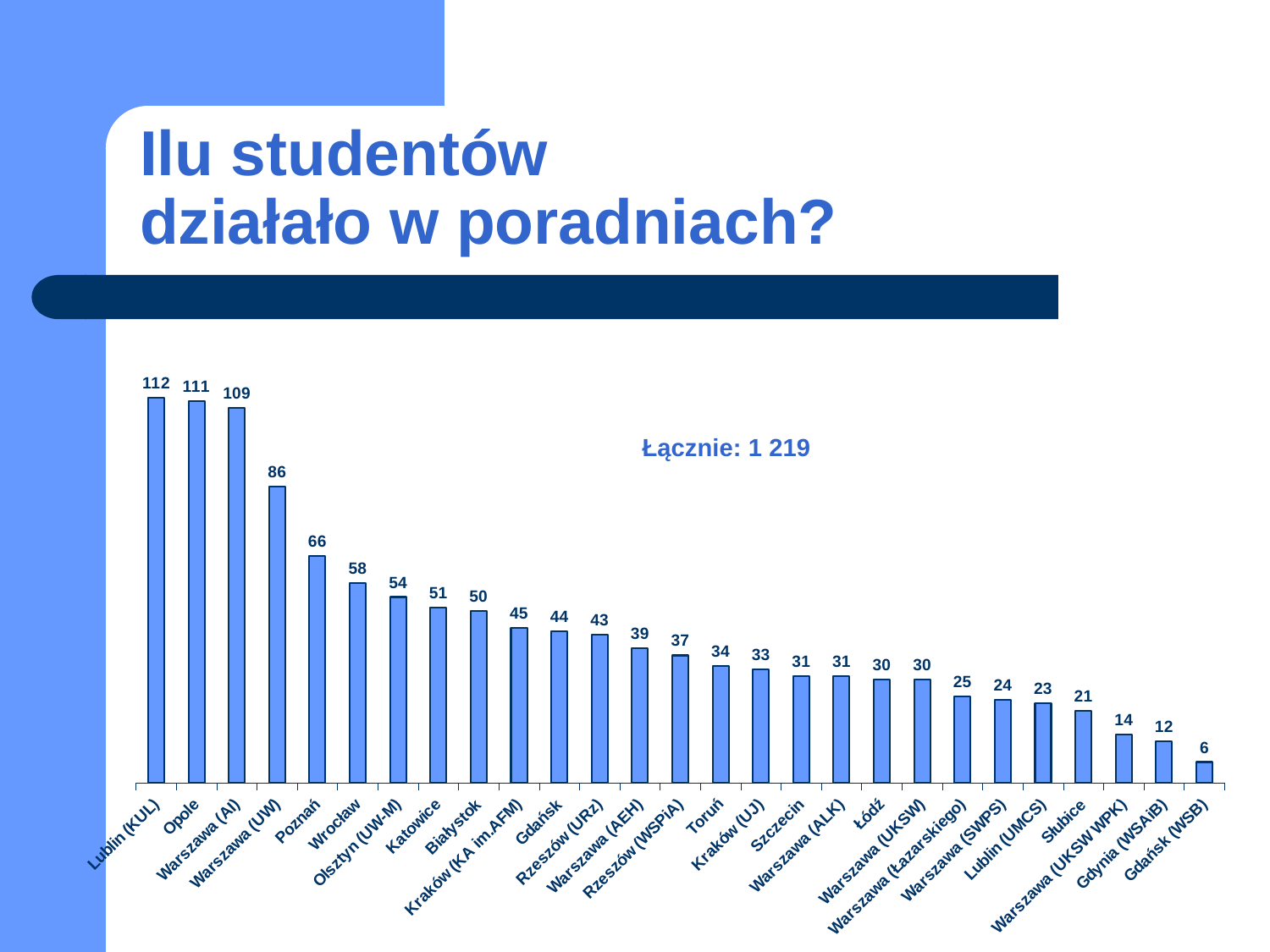
What kind of chart is shown on the slide? Bar chart How many categories are plotted on the chart? 27 What is the value for Poznań? 66 How many students are shown for Warszawa (UW)? 86 What is the value for Gdynia (WSAiB)? 12 What is the difference between the values for Lublin (KUL) and Opole? 1 Which category has the highest value? Lublin (KUL) Which category has the lowest value? Gdańsk (WSB) Which is larger, the value for Białystok or the value for Gdańsk? Białystok What is the value for Kraków (UJ)? 33 What total is printed on the chart after 'Łącznie'? 1 219 What is the difference between the values for Wrocław and Toruń? 24